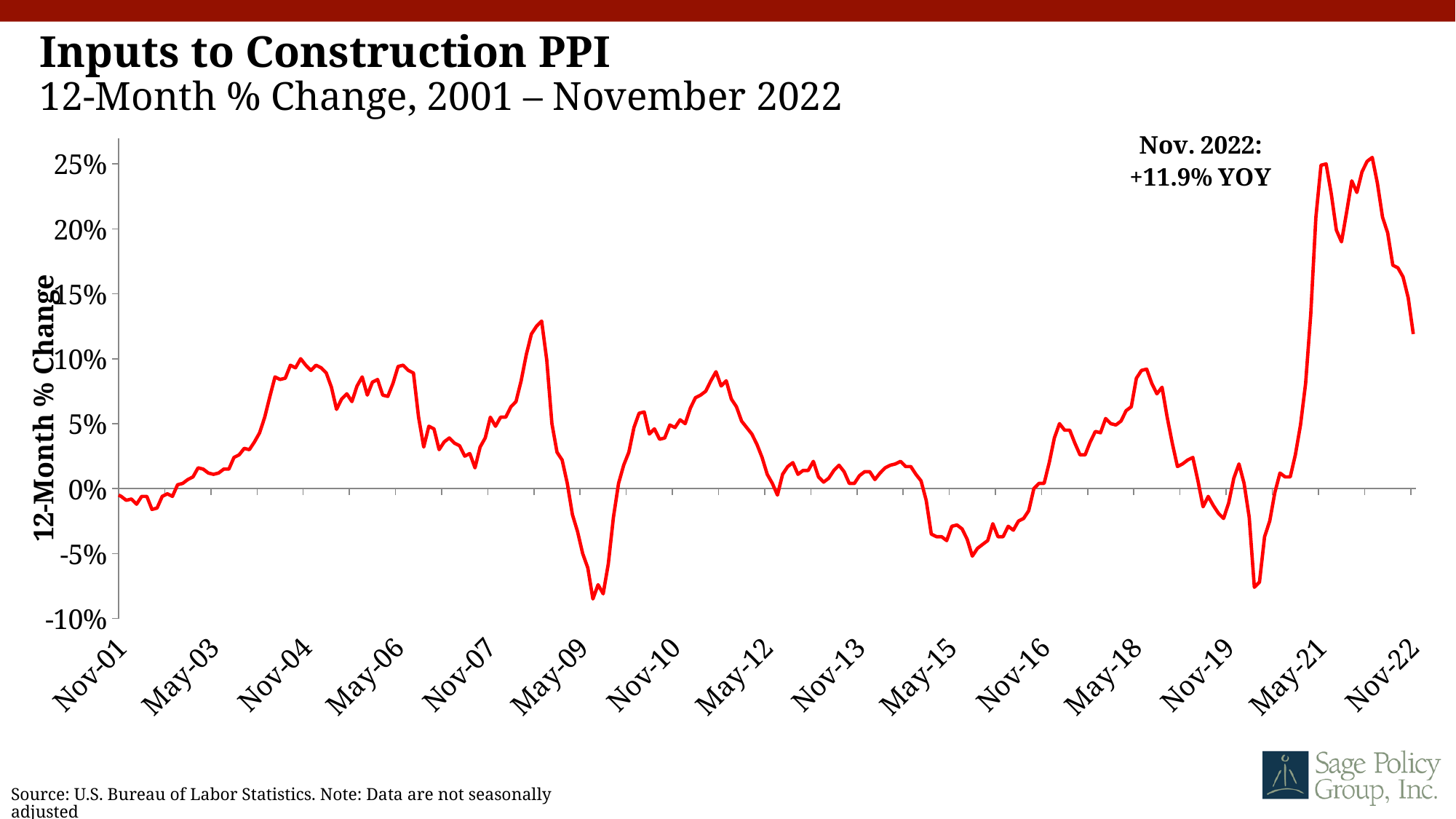
How many date labels are shown on the x axis? 15 Is the value at May-09 greater or less than 0%? less Does the line rise or fall between Nov-19 and May-21? rises What kind of chart is shown on the slide? line chart What is the 12-month % change for November 2022 shown on the chart? +11.9% YOY Is the value at May-15 greater or less than 0%? less Is the value at Nov-04 greater or less than 5%? greater Does the line rise or fall between Nov-07 and May-09? falls What is the title of the y axis? 12-Month % Change